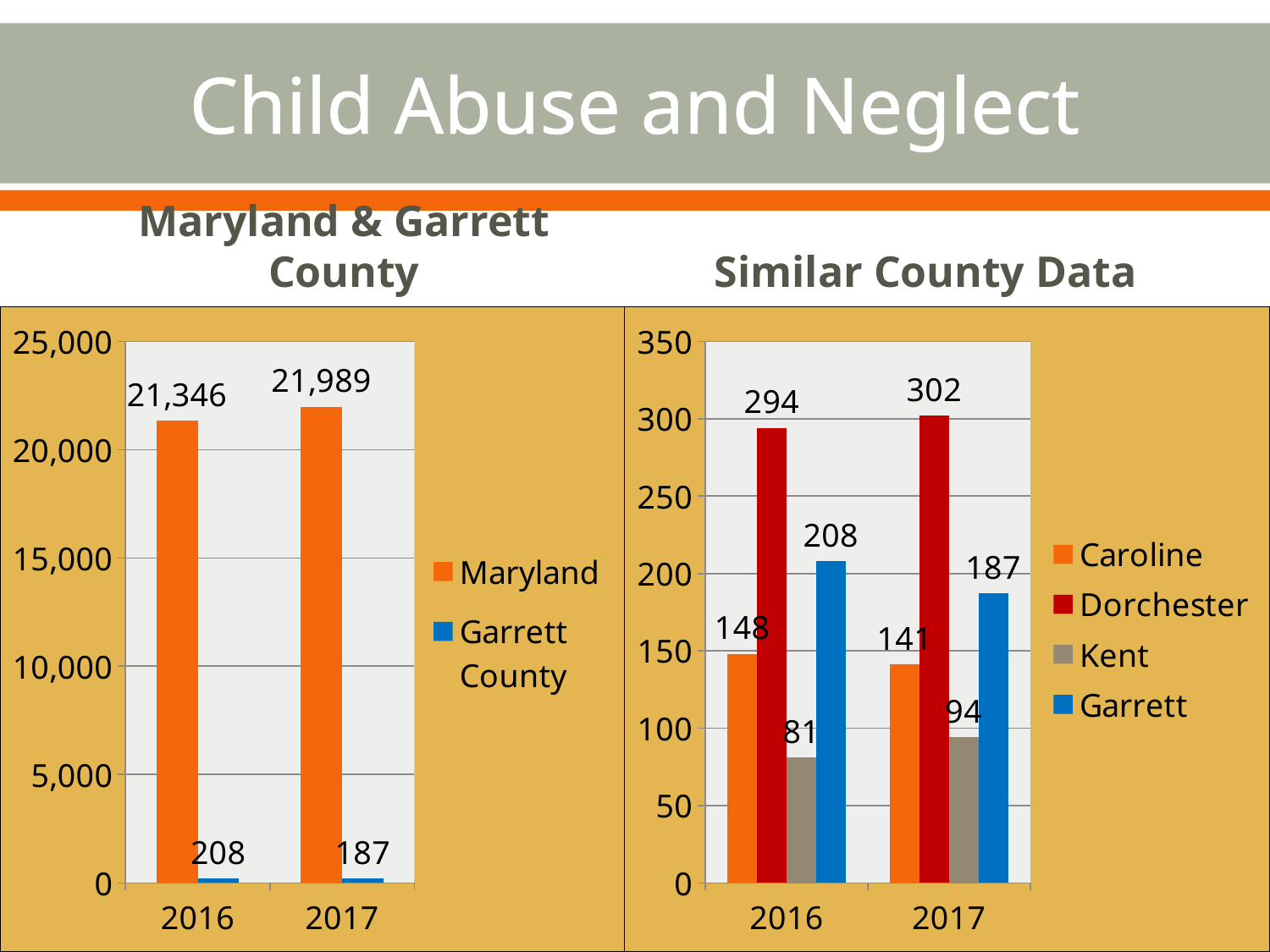
In the 'Maryland & Garrett County' chart, what is the value for Maryland in 2016? 21,346 In the 'Maryland & Garrett County' chart, how many series does the legend list? 2 What kind of chart is the 'Similar County Data' chart? bar chart In the 'Similar County Data' chart, what is the value for Dorchester in 2017? 302 In the 'Maryland & Garrett County' chart, what is the value for Garrett County in 2017? 187 In the 'Similar County Data' chart, what is the value for Kent in 2016? 81 In the 'Maryland & Garrett County' chart, does the Maryland value rise or fall from 2016 to 2017? rise In the 'Maryland & Garrett County' chart, what is the difference between the Maryland values for 2017 and 2016? 643 In the 'Similar County Data' chart, which county has the highest value in 2016? Dorchester In the 'Similar County Data' chart, which is larger: Caroline in 2016 or Garrett in 2016? Garrett in 2016 In the 'Similar County Data' chart, which county has the lowest value in 2017? Kent In the 'Similar County Data' chart, what is the difference between the Garrett values for 2016 and 2017? 21